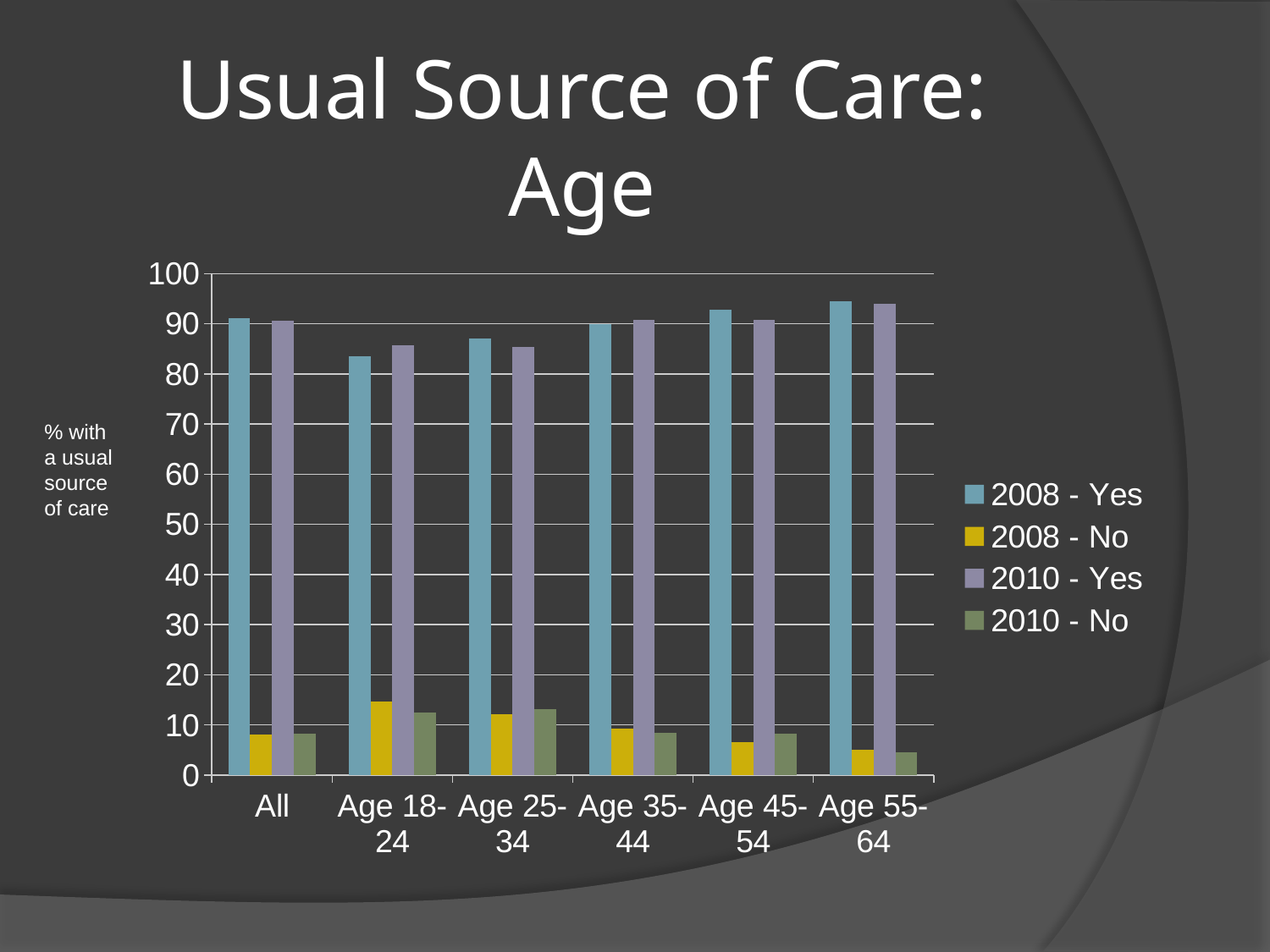
Is the 2010 - Yes value for Age 55-64 greater or less than 90? greater Which category has the highest value for the 2008 - No series? Age 18-24 For Age 18-24, which is larger: the 2008 - Yes value or the 2010 - Yes value? 2010 - Yes Do the 2008 - Yes values rise or fall across the age groups from Age 18-24 to Age 55-64? rise How many categories are shown on the x axis? 6 Is the 2008 - Yes value for Age 18-24 greater or less than 90? less Which category has the lowest value for the 2008 - Yes series? Age 18-24 Which category has the highest value for the 2008 - Yes series? Age 55-64 What kind of chart is shown on the slide? bar chart How many series does the legend list? 4 Is the 2008 - No value for Age 18-24 greater or less than 10? greater What is the label on the vertical axis of the chart? % with a usual source of care